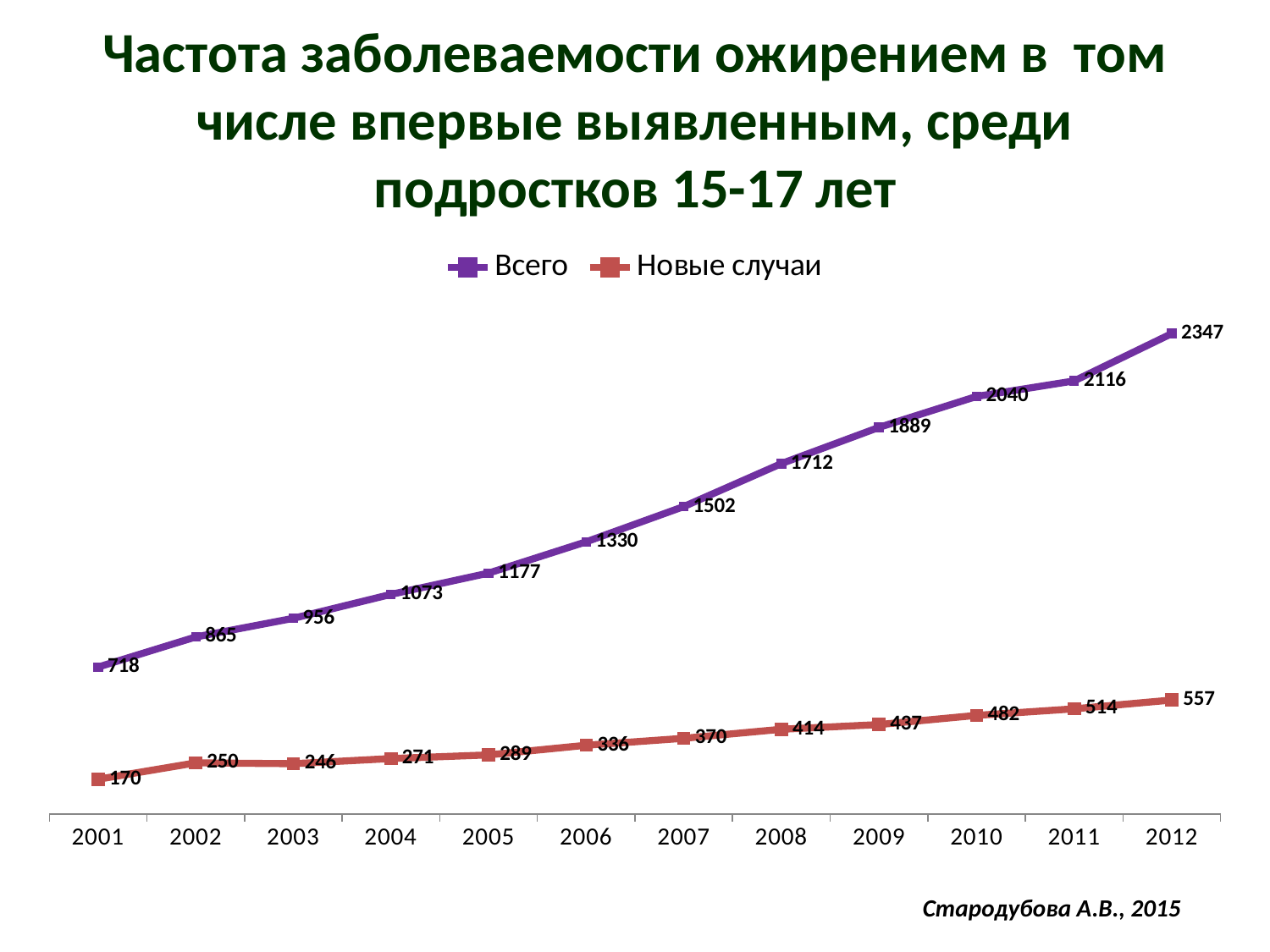
What kind of chart is shown on the slide? line chart In which year is the "Всего" series at its lowest? 2001 Which is larger: the "Новые случаи" value in 2002 or in 2003? 2002 What is the difference between the "Всего" and "Новые случаи" values in 2006? 994 How many years are shown on the x axis? 12 What is the value of the "Новые случаи" series in 2001? 170 What is the value of the "Новые случаи" series in 2009? 437 What is the difference between the "Всего" values in 2012 and 2001? 1629 What is the value of the "Всего" series in 2012? 2347 In which year is the "Новые случаи" series at its highest? 2012 How many series does the legend list? 2 What is the value of the "Всего" series in 2007? 1502